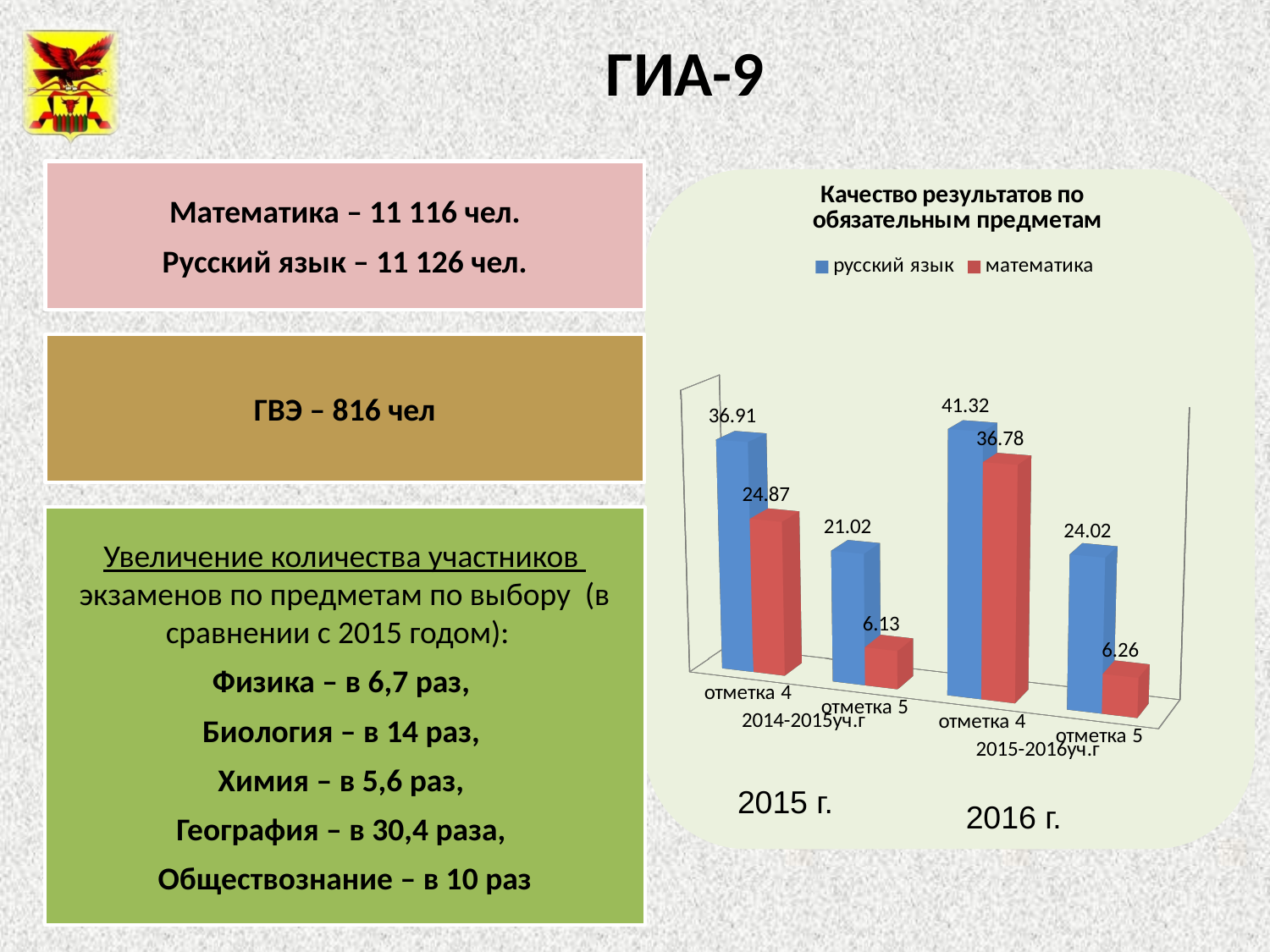
What is the value for русский язык for отметка 4 in 2014-2015 уч.г? 36.91 What is the title of the chart? Качество результатов по обязательным предметам For отметка 5 in 2014-2015 уч.г, which is larger: русский язык or математика? русский язык Which bar has the lowest value on the chart? математика, отметка 5, 2014-2015 уч.г How many categories are shown on the x axis? 4 How many series does the legend list? 2 What kind of chart is shown? bar chart What is the value for русский язык for отметка 4 in 2015-2016 уч.г? 41.32 What is the value for математика for отметка 5 in 2015-2016 уч.г? 6.26 Which bar has the highest value on the chart? русский язык, отметка 4, 2015-2016 уч.г What is the value for математика for отметка 4 in 2014-2015 уч.г? 24.87 What is the difference between русский язык and математика for отметка 4 in 2015-2016 уч.г? 4.54